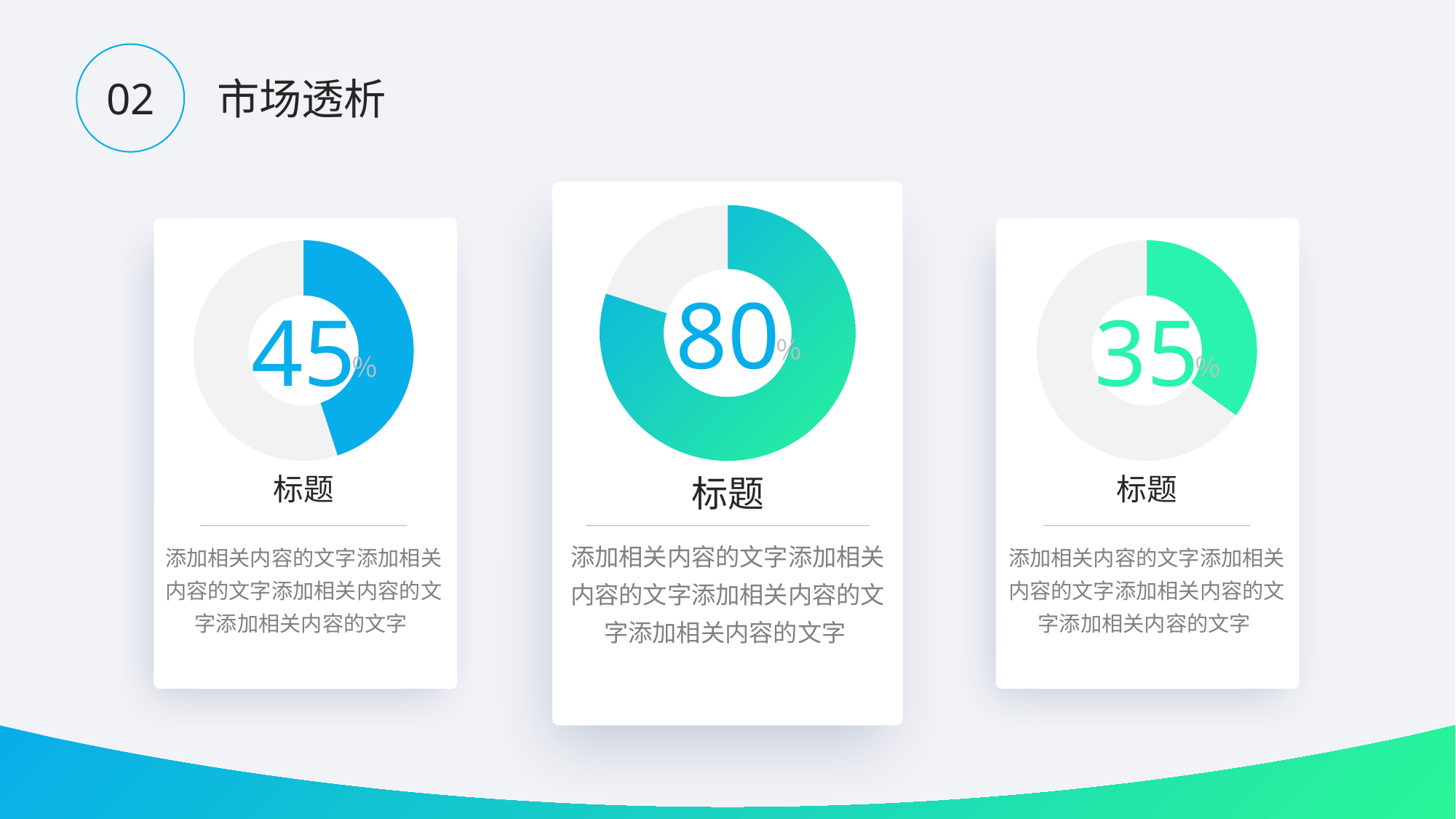
Which of the three donut charts shows the highest percentage? The middle chart (80%) Which of the three donut charts shows the lowest percentage? The right chart (35%) What colour is the filled portion of the left donut chart? Blue What percentage is shown in the centre of the right donut chart? 35% What is the difference between the percentage in the left donut chart and the percentage in the right donut chart? 10% Which is larger, the percentage in the left donut chart or the percentage in the right donut chart? The left chart (45%) What percentage is shown in the centre of the left donut chart? 45% How many donut charts are shown on the slide? 3 Is the percentage shown in the middle donut chart greater or less than 50%? greater What is the difference between the percentage in the middle donut chart and the percentage in the left donut chart? 35% What percentage is shown in the centre of the middle donut chart? 80% What kind of chart is used in each of the three cards on the slide? Donut (pie) chart